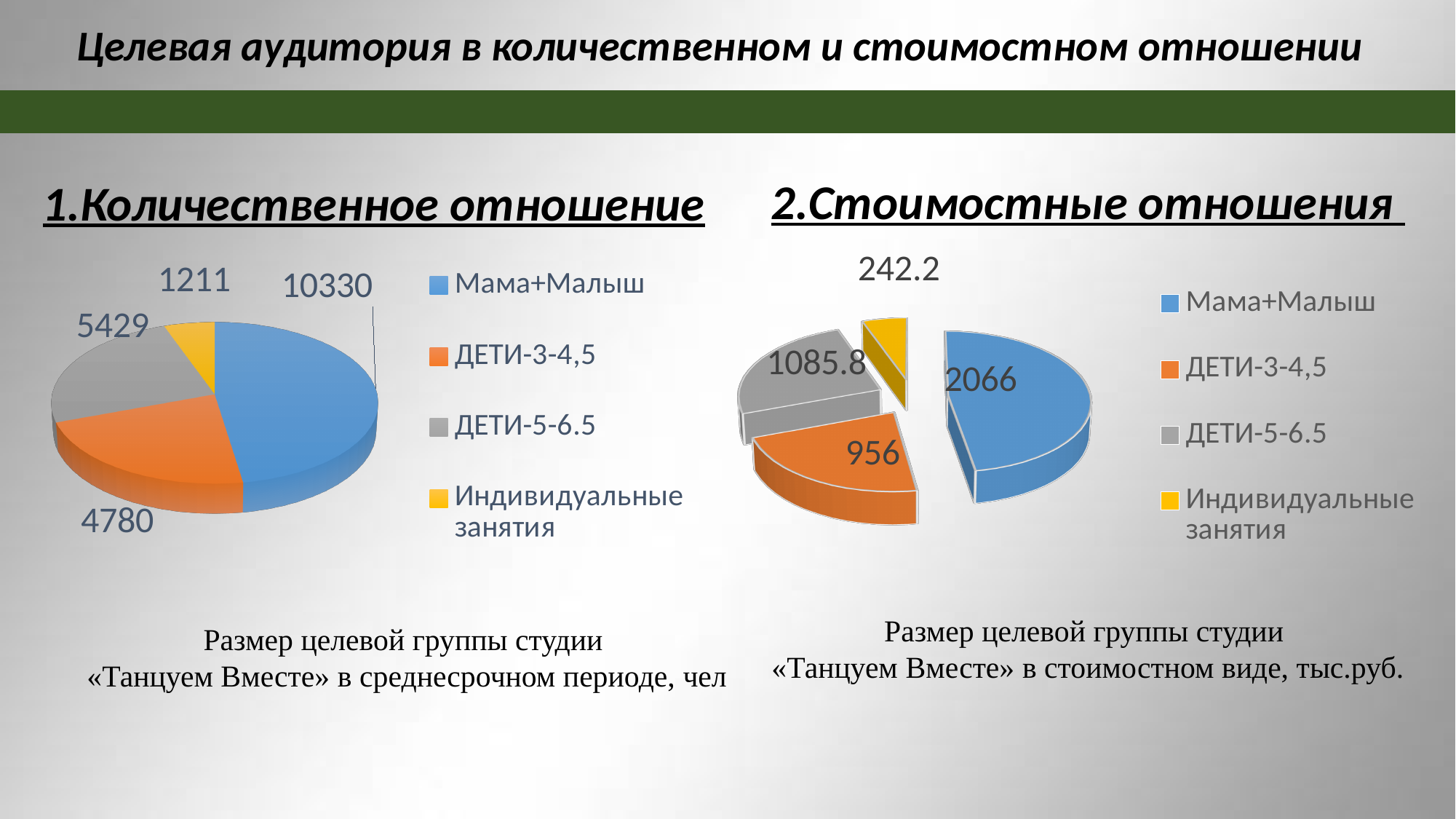
In the right pie chart (Стоимостные отношения), what is the value for Индивидуальные занятия? 242.2 In the right pie chart (Стоимостные отношения), what is the difference between ДЕТИ-5-6.5 and ДЕТИ-3-4,5? 129.8 In the left pie chart (Количественное отношение), what is the difference between Мама+Малыш and ДЕТИ-3-4,5? 5550 In the left pie chart (Количественное отношение), what is the value for Мама+Малыш? 10330 In the left pie chart (Количественное отношение), which category has the largest value? Мама+Малыш What type of chart is used on the left side of the slide (Количественное отношение)? Pie chart How many categories does the right pie chart (Стоимостные отношения) show? 4 In the left pie chart (Количественное отношение), which is larger: ДЕТИ-5-6.5 or ДЕТИ-3-4,5? ДЕТИ-5-6.5 In the right pie chart (Стоимостные отношения), what colour represents ДЕТИ-5-6.5? Grey In the right pie chart (Стоимостные отношения), what is the value for ДЕТИ-3-4,5? 956 In the left pie chart (Количественное отношение), what is the value for ДЕТИ-5-6.5? 5429 In the right pie chart (Стоимостные отношения), which category has the smallest value? Индивидуальные занятия